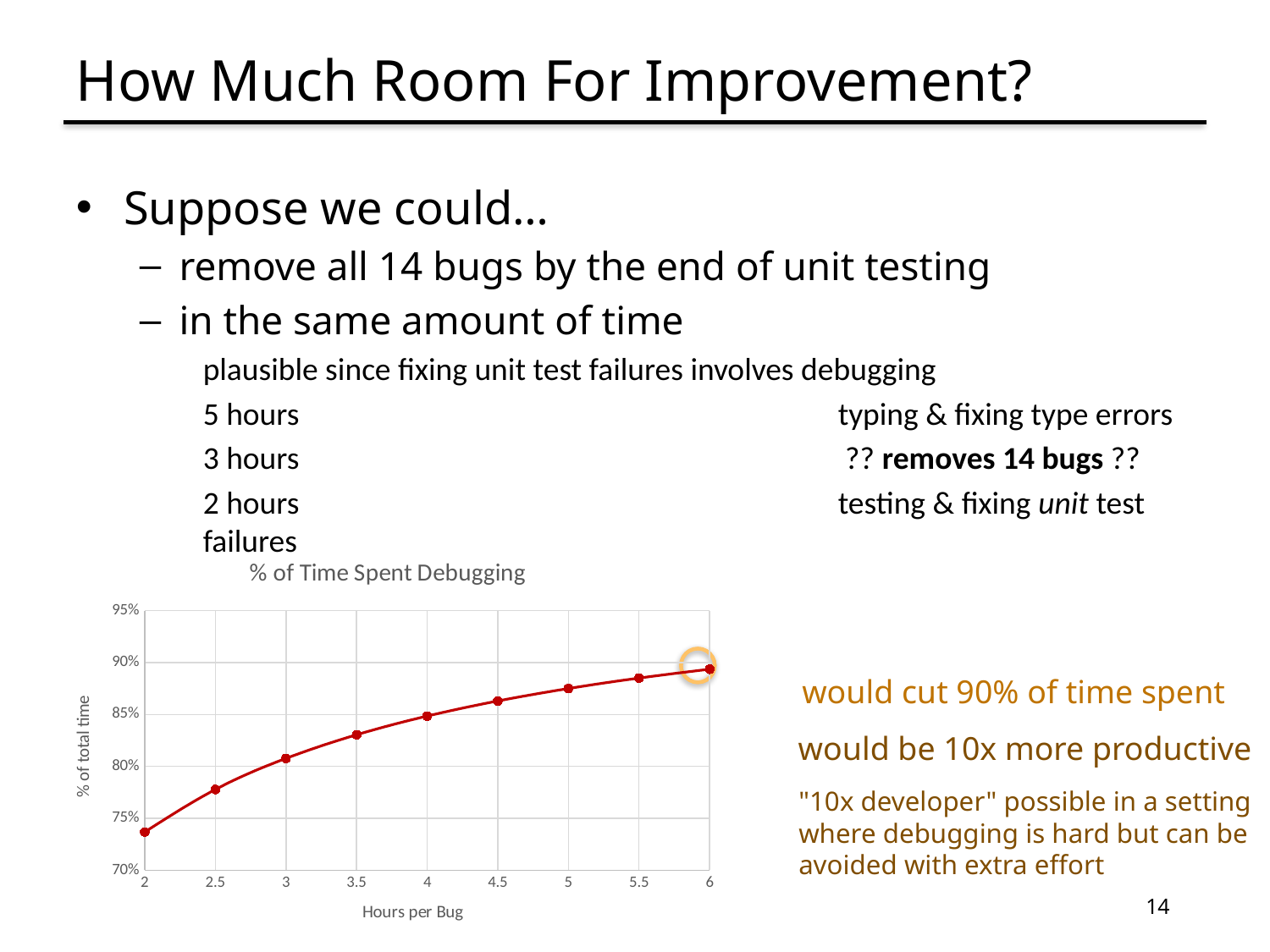
Do the values rise or fall as Hours per Bug increases? rise Which is larger, the value at 2.5 hours per bug or the value at 4.5 hours per bug? 4.5 hours per bug Is the value at 3.5 hours per bug greater or less than 85%? less How many data points are plotted on the line? 9 Is the value at 2 hours per bug greater or less than 75%? less What is the title of the chart? % of Time Spent Debugging Is the value at 5 hours per bug greater or less than 85%? greater What is the label of the x axis of the chart? Hours per Bug At which Hours per Bug value is the % of total time highest? 6 What kind of chart is shown on the slide? line chart At which Hours per Bug value is the % of total time lowest? 2